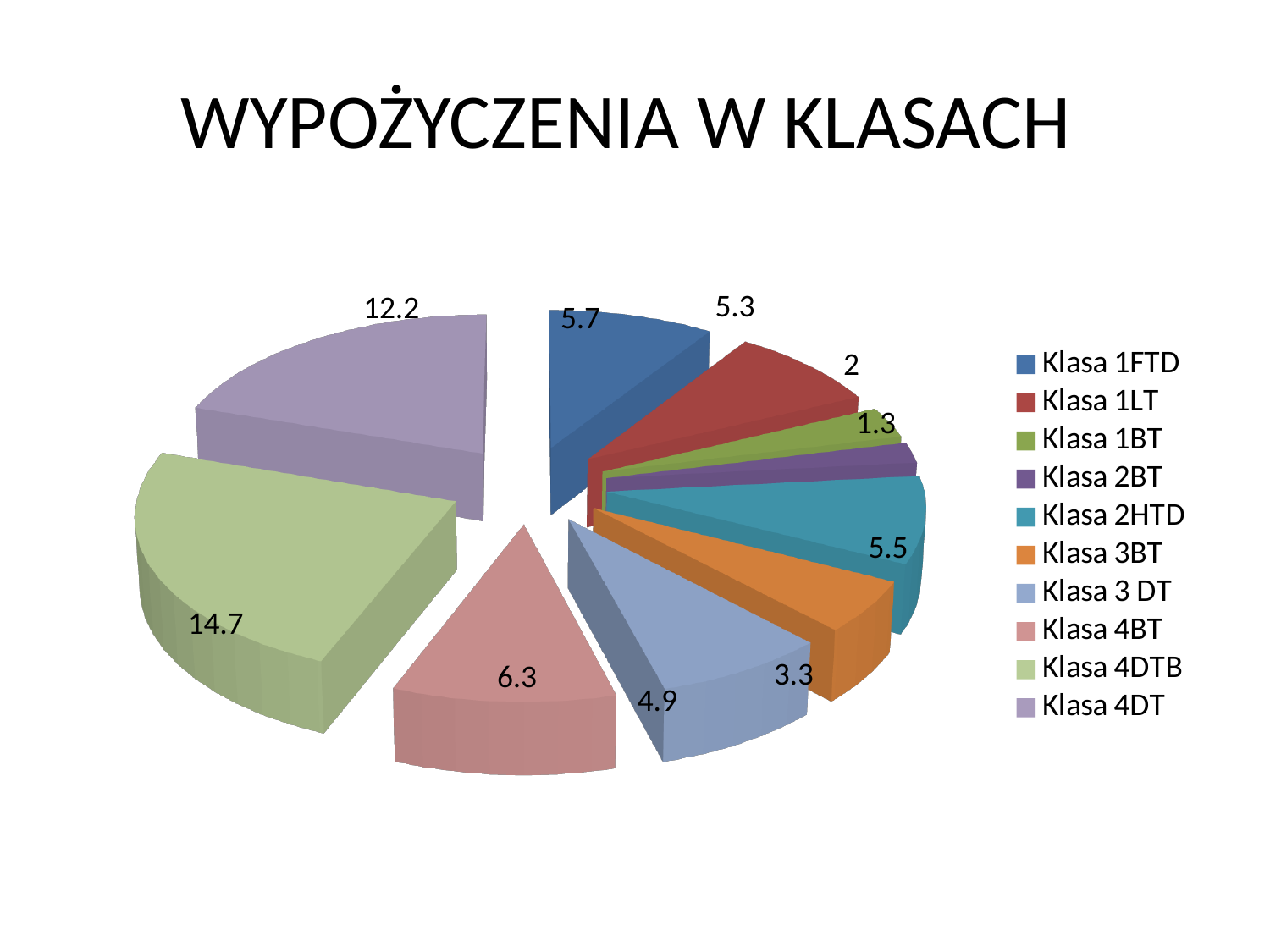
Which class has the highest value? Klasa 4DTB What is the value for Klasa 4BT? 6.3 How many classes are shown in the pie chart? 10 What is the title of the chart? WYPOŻYCZENIA W KLASACH Which class has the lowest value? Klasa 2BT What is the value for Klasa 2HTD? 5.5 What is the value for Klasa 1FTD? 5.7 Which is larger, the value for Klasa 3BT or the value for Klasa 3 DT? Klasa 3 DT What is the difference between the values for Klasa 4DTB and Klasa 4DT? 2.5 What kind of chart is shown on the slide? Pie chart What is the difference between the values for Klasa 4BT and Klasa 3 DT? 1.4 What is the value for Klasa 4DTB? 14.7